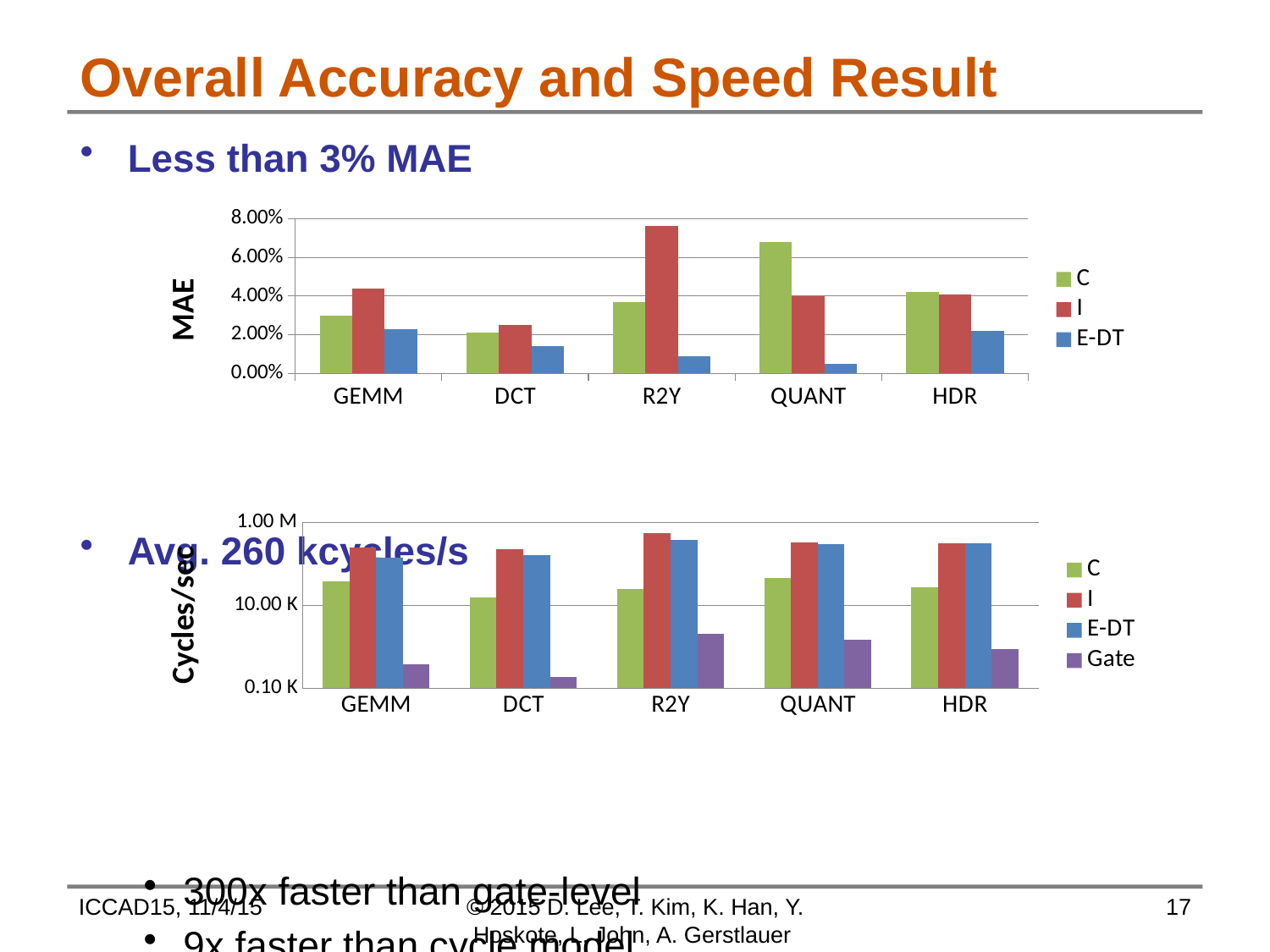
What kind of chart is the top chart on the slide? bar chart How many categories are shown on the x axis of the top chart? 5 In the top chart, which series has the lowest value for R2Y? E-DT How many series does the legend of the top chart list? 3 How many series does the legend of the bottom chart list? 4 In the top chart, for QUANT, which is larger: the C value or the I value? C In the bottom chart, is the Gate value for DCT greater or less than 10.00 K? less In the top chart, is the I value for R2Y greater or less than 6.00%? greater In the top chart, is the E-DT value for QUANT greater or less than 2.00%? less In the bottom chart, which series has the lowest value for GEMM? Gate In the top chart, which category has the highest value for the I series? R2Y What is the y-axis label of the bottom chart? Cycles/sec